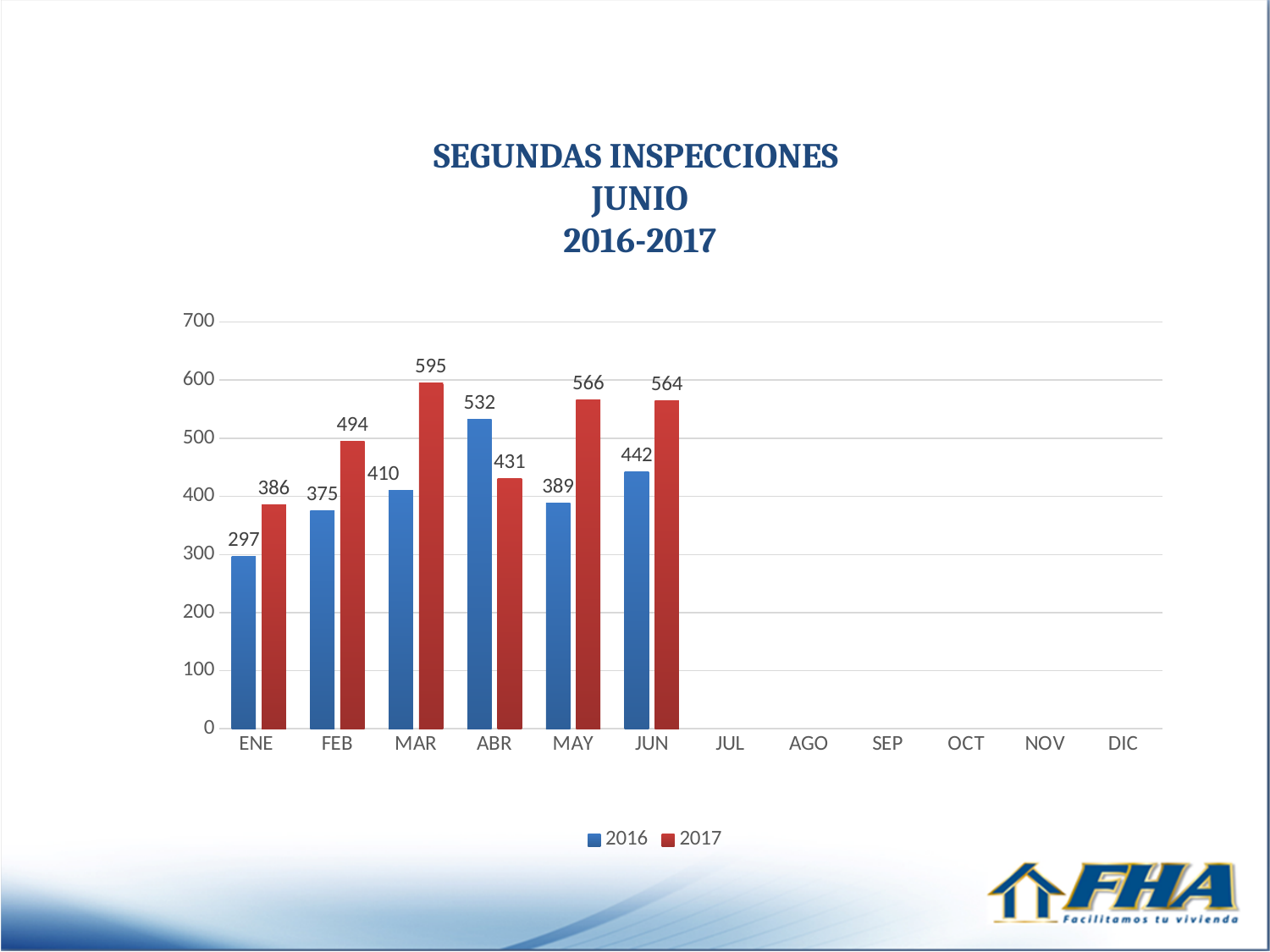
What colour represents the 2017 series? red Which month has the lowest value for the 2016 series? ENE What is the value for 2017 in MAR? 595 What kind of chart is shown on the slide? bar chart What is the difference between the 2017 and 2016 values in MAY? 177 Which is larger in ABR, the 2016 value or the 2017 value? 2016 How many months have data plotted in the chart? 6 How many series does the legend list? 2 What is the value for 2016 in ENE? 297 Which month has the highest value for the 2017 series? MAR What is the value for 2016 in ABR? 532 Is the value for 2016 in JUN greater or less than 400? greater